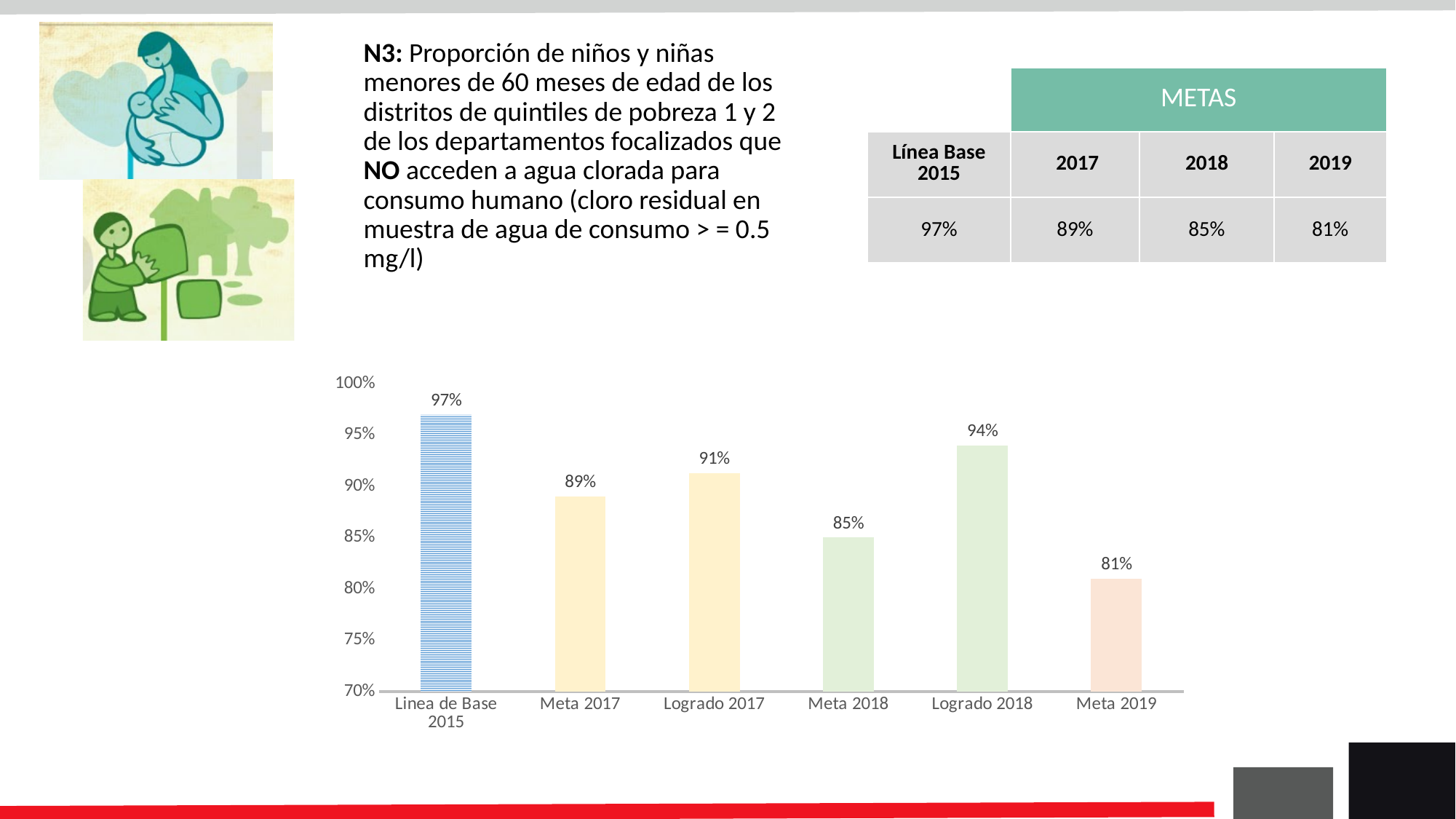
Which category has the lowest value? Meta 2019 What is the value for Logrado 2018? 94% What is the value for Logrado 2017? 91% What is the difference between Linea de Base 2015 and Meta 2019? 16% How many bars are shown in the chart? 6 What is the lowest value shown on the vertical axis? 70% What kind of chart is shown on the slide? Bar chart What is the value for Meta 2019? 81% Which category has the highest value? Linea de Base 2015 What is the value for Linea de Base 2015? 97% What is the difference between Logrado 2018 and Meta 2018? 9% Which is larger, Meta 2017 or Logrado 2017? Logrado 2017